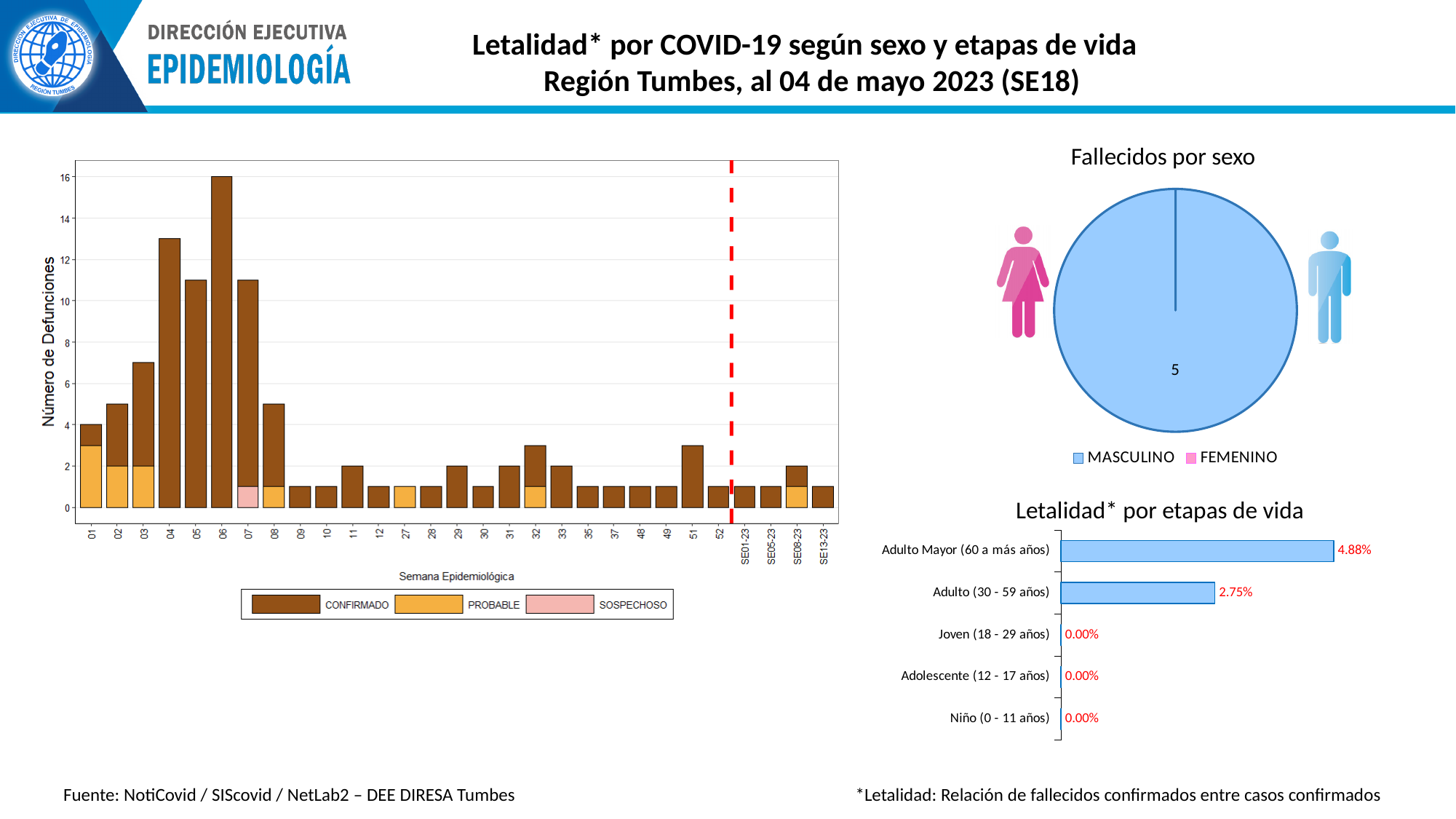
In the 'Letalidad* por etapas de vida' chart, what is the value for Adulto Mayor (60 a más años)? 4.88% In the 'Letalidad* por etapas de vida' chart, what is the value for Joven (18 - 29 años)? 0.00% In the 'Letalidad* por etapas de vida' chart, what is the value for Adulto (30 - 59 años)? 2.75% What kind of chart is 'Fallecidos por sexo'? pie chart How many series does the legend of the bar chart on the left (Número de Defunciones) list? 3 In the 'Fallecidos por sexo' pie chart, what value is printed on the MASCULINO slice? 5 In the 'Letalidad* por etapas de vida' chart, which age group has the highest value? Adulto Mayor (60 a más años) In the 'Letalidad* por etapas de vida' chart, how many age groups are shown? 5 In the bar chart on the left (Número de Defunciones by Semana Epidemiológica), is the value for week 04 greater or less than 12? greater In the bar chart on the left (Número de Defunciones by Semana Epidemiológica), which week has the highest bar? 06 How many entries does the legend of the 'Fallecidos por sexo' chart list? 2 In the 'Letalidad* por etapas de vida' chart, what is the difference between the values for Adulto Mayor (60 a más años) and Adulto (30 - 59 años)? 2.13%